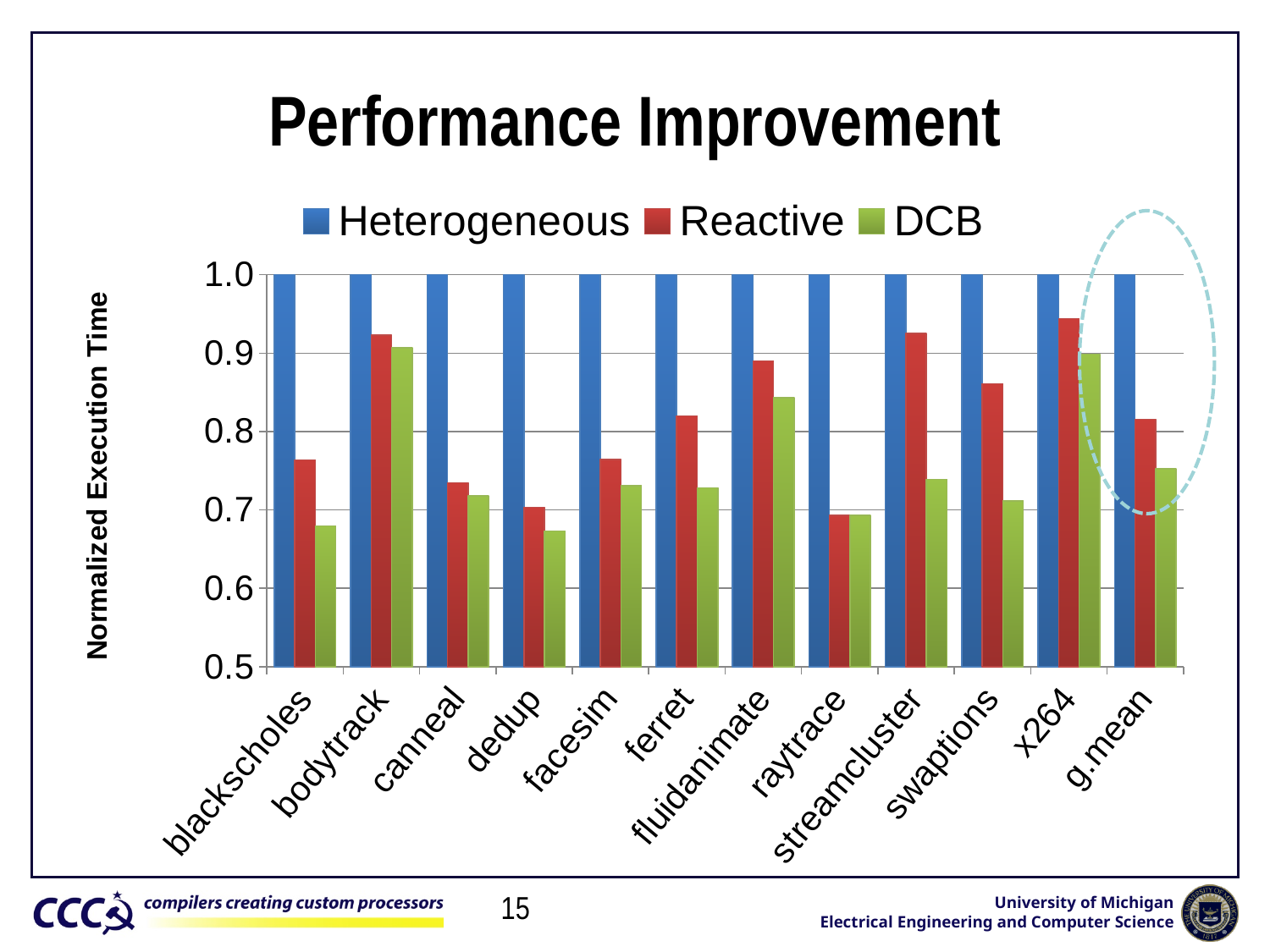
What is the Heterogeneous value for blackscholes? 1.0 Is the Reactive value for x264 greater or less than 0.9? greater What kind of chart is shown on the slide? bar chart For streamcluster, which is larger: the Reactive value or the DCB value? Reactive What is the title of the y axis? Normalized Execution Time How many series does the legend list? 3 Is the DCB value for blackscholes greater or less than 0.7? less How many categories are shown along the x axis of the chart? 12 Which category has the highest Reactive value? x264 Which has the larger Reactive value: blackscholes or bodytrack? bodytrack Is the Reactive value for swaptions greater or less than 0.8? greater